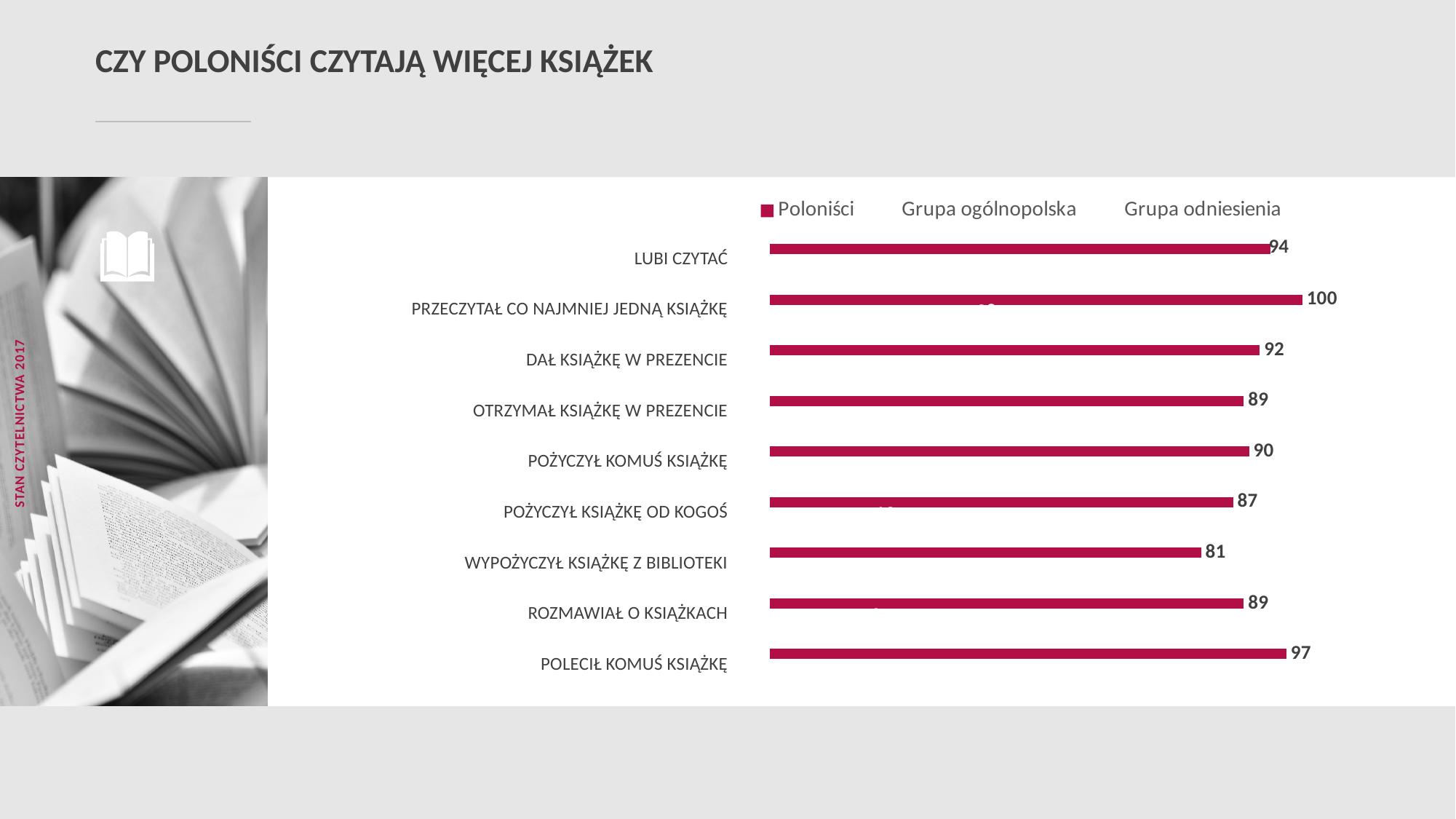
What is the value for Poloniści for WYPOŻYCZYŁ KSIĄŻKĘ Z BIBLIOTEKI? 81 What is the difference between the Poloniści values for PRZECZYTAŁ CO NAJMNIEJ JEDNĄ KSIĄŻKĘ and WYPOŻYCZYŁ KSIĄŻKĘ Z BIBLIOTEKI? 19 Which category has the highest value for Poloniści? PRZECZYTAŁ CO NAJMNIEJ JEDNĄ KSIĄŻKĘ How many series does the legend list? 3 What kind of chart is shown on the slide? Bar chart Which category has the lowest value for Poloniści? WYPOŻYCZYŁ KSIĄŻKĘ Z BIBLIOTEKI How many categories are shown in the chart? 9 What is the value for Poloniści for POLECIŁ KOMUŚ KSIĄŻKĘ? 97 What is the value for Poloniści for POŻYCZYŁ KSIĄŻKĘ OD KOGOŚ? 87 What is the title of the slide containing the chart? CZY POLONIŚCI CZYTAJĄ WIĘCEJ KSIĄŻEK What is the value for Poloniści for LUBI CZYTAĆ? 94 Which has a larger Poloniści value: DAŁ KSIĄŻKĘ W PREZENCIE or OTRZYMAŁ KSIĄŻKĘ W PREZENCIE? DAŁ KSIĄŻKĘ W PREZENCIE